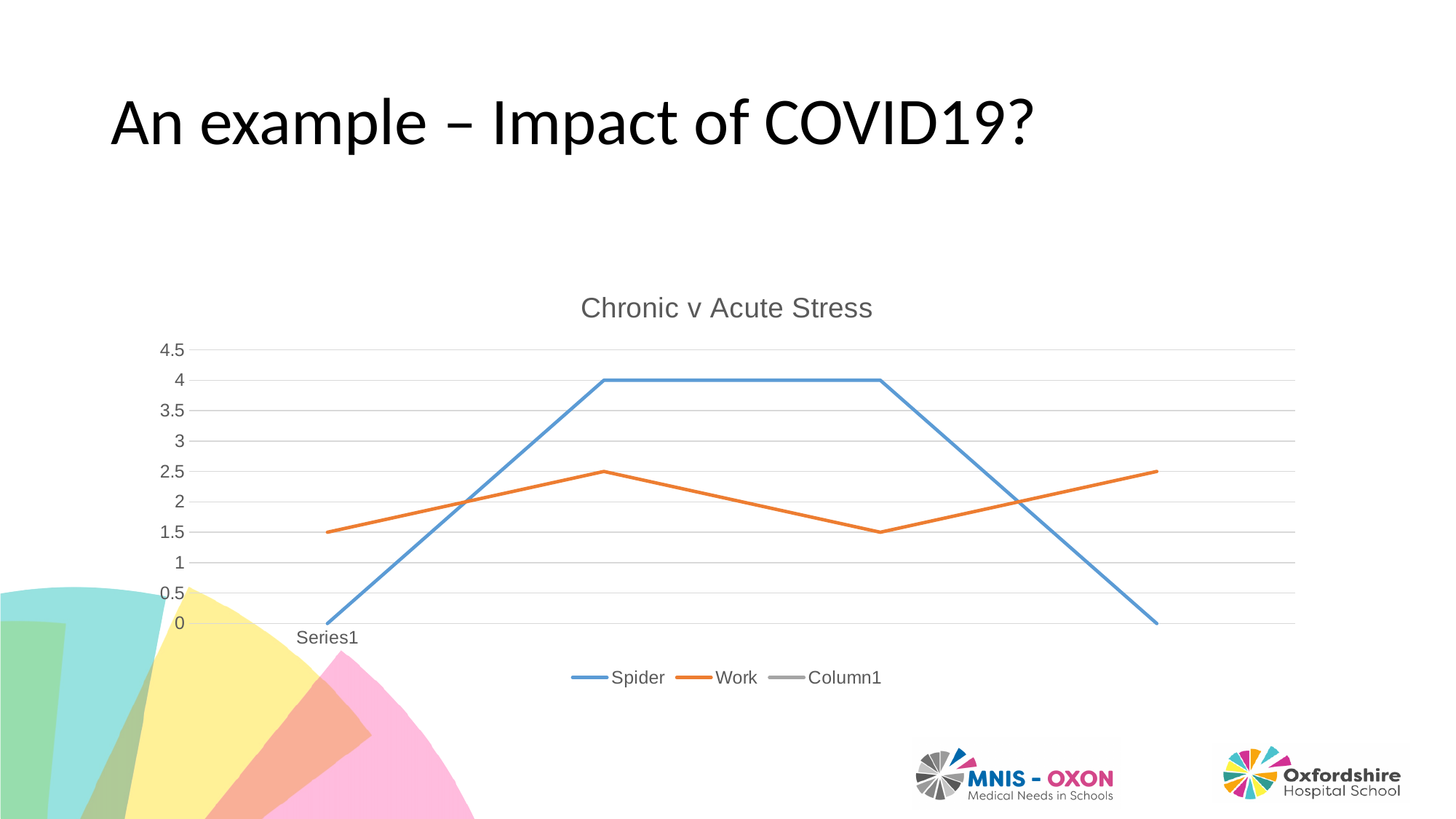
How many data points does the Spider line have? 4 Which series are listed in the legend? Spider, Work, Column1 What is the difference between the Work value and the Spider value at Series1? 1.5 What is the highest value reached by the Spider line? 4 What is the value of the Work line at Series1? 1.5 At Series1, which is larger, the Spider value or the Work value? Work What is the title of the chart? Chronic v Acute Stress What is the highest value reached by the Work line? 2.5 What is the value of the Spider line at Series1? 0 What is the lowest value reached by the Work line? 1.5 How many series does the legend list? 3 What kind of chart is shown on the slide? line chart